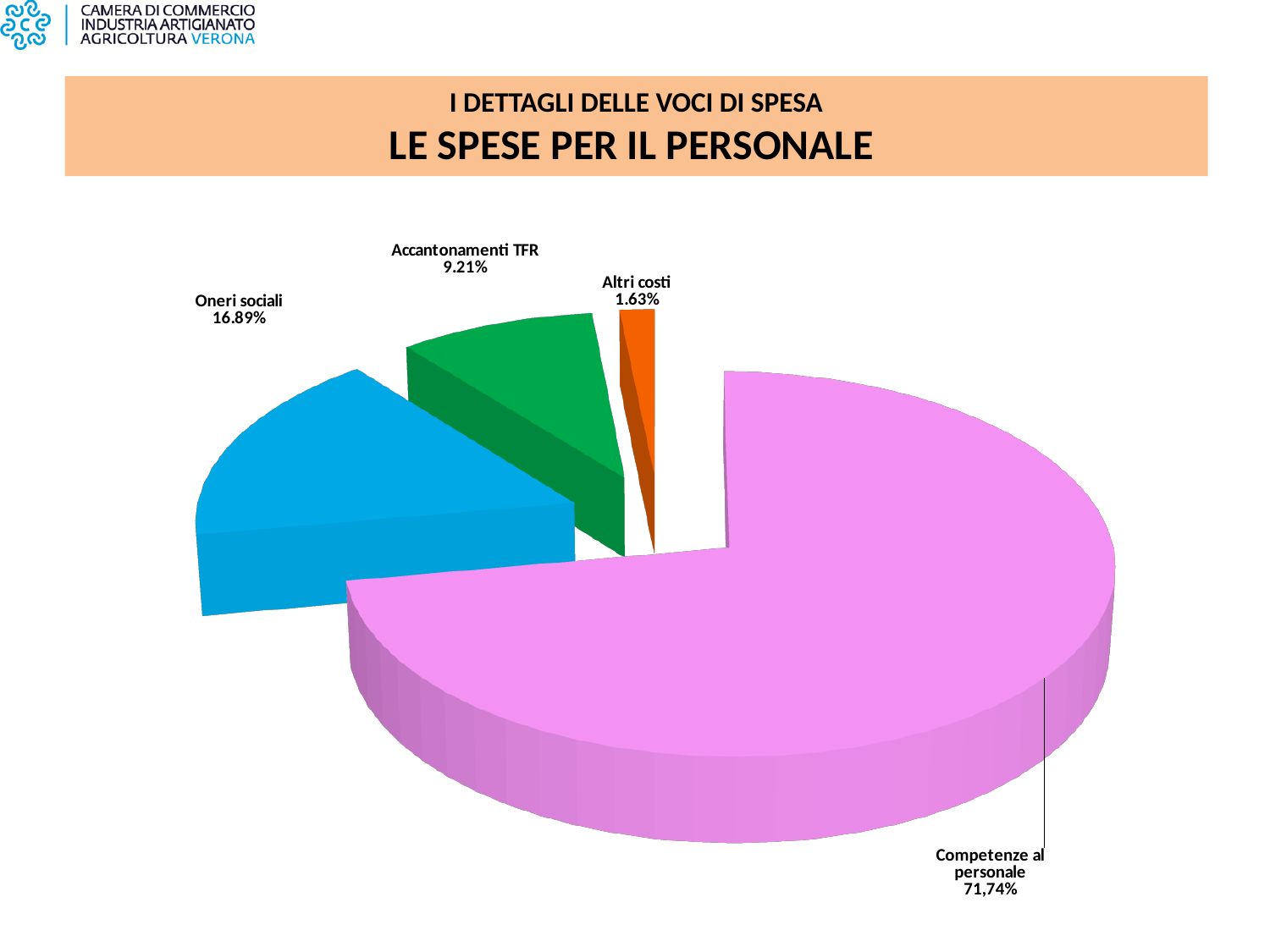
What colour is the slice for Competenze al personale? Pink What is the difference in percentage points between the Oneri sociali share and the Accantonamenti TFR share? 7.68 How many slices does the pie chart have? 4 What kind of chart is shown on the slide? Pie chart What share of the pie is labelled for Accantonamenti TFR? 9.21% Which is larger, the share for Oneri sociali or the share for Accantonamenti TFR? Oneri sociali Which slice of the pie is the largest? Competenze al personale What share of the pie is labelled for Competenze al personale? 71,74% What share of the pie is labelled for Oneri sociali? 16.89% Which slice of the pie is the smallest? Altri costi What share of the pie is labelled for Altri costi? 1.63% What is the difference in percentage points between the Accantonamenti TFR share and the Altri costi share? 7.58